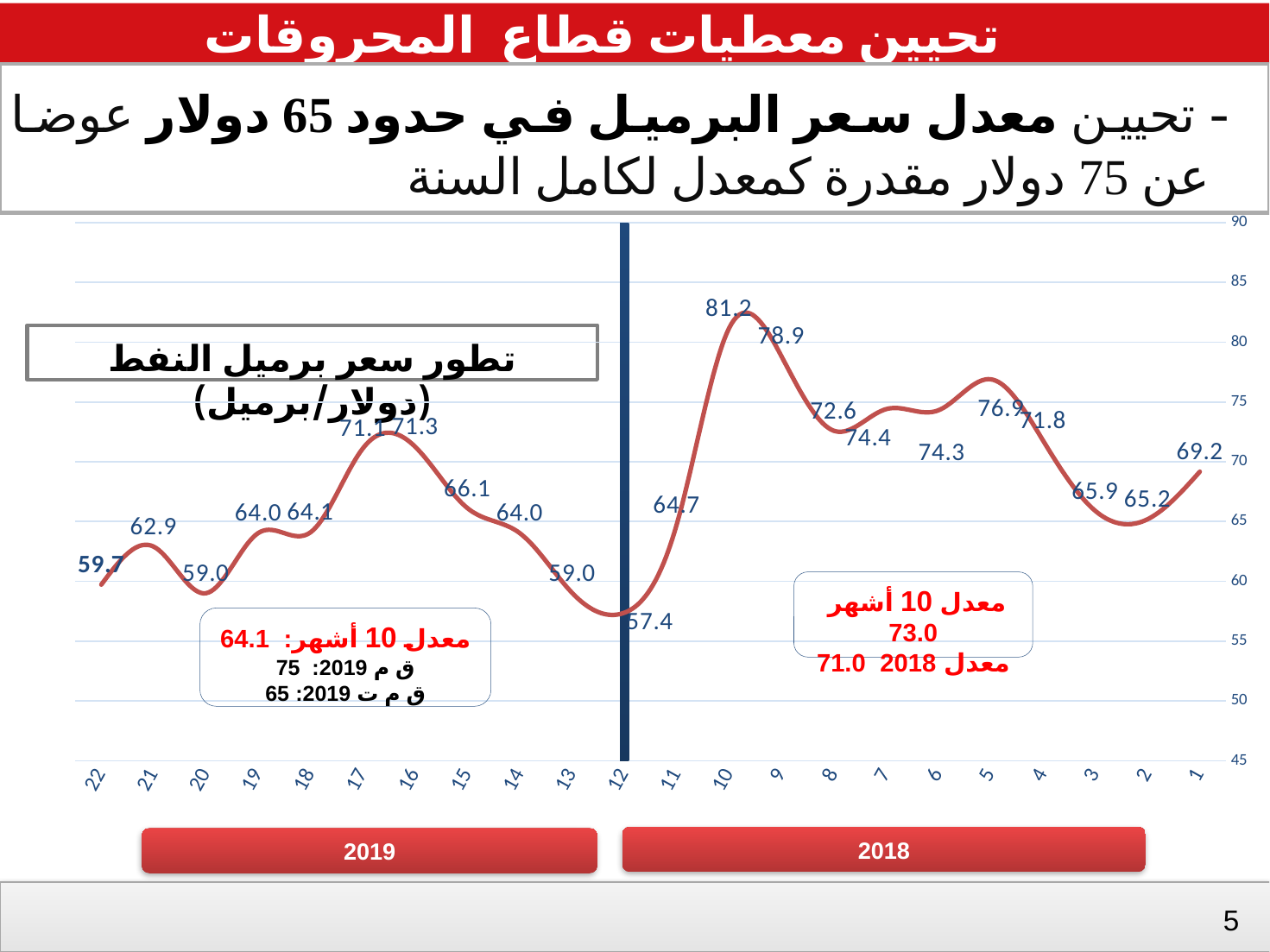
What is the value at point 12 on the x axis? 57.4 What is the value at point 10 on the x axis? 81.2 Do the values rise or fall from point 12 to point 10? rise Which x-axis point has the lowest value? 12 What is the value at point 5 on the x axis? 76.9 Which is larger, the value at point 16 or the value at point 15? point 16 What is the title of the chart? تطور سعر برميل النفط (دولار/برميل) Which x-axis point has the highest value? 10 What kind of chart is shown on the slide? line chart What is the value at point 22 on the x axis? 59.7 How many data points are plotted on the chart? 22 What is the difference between the values at point 10 and point 12? 23.8